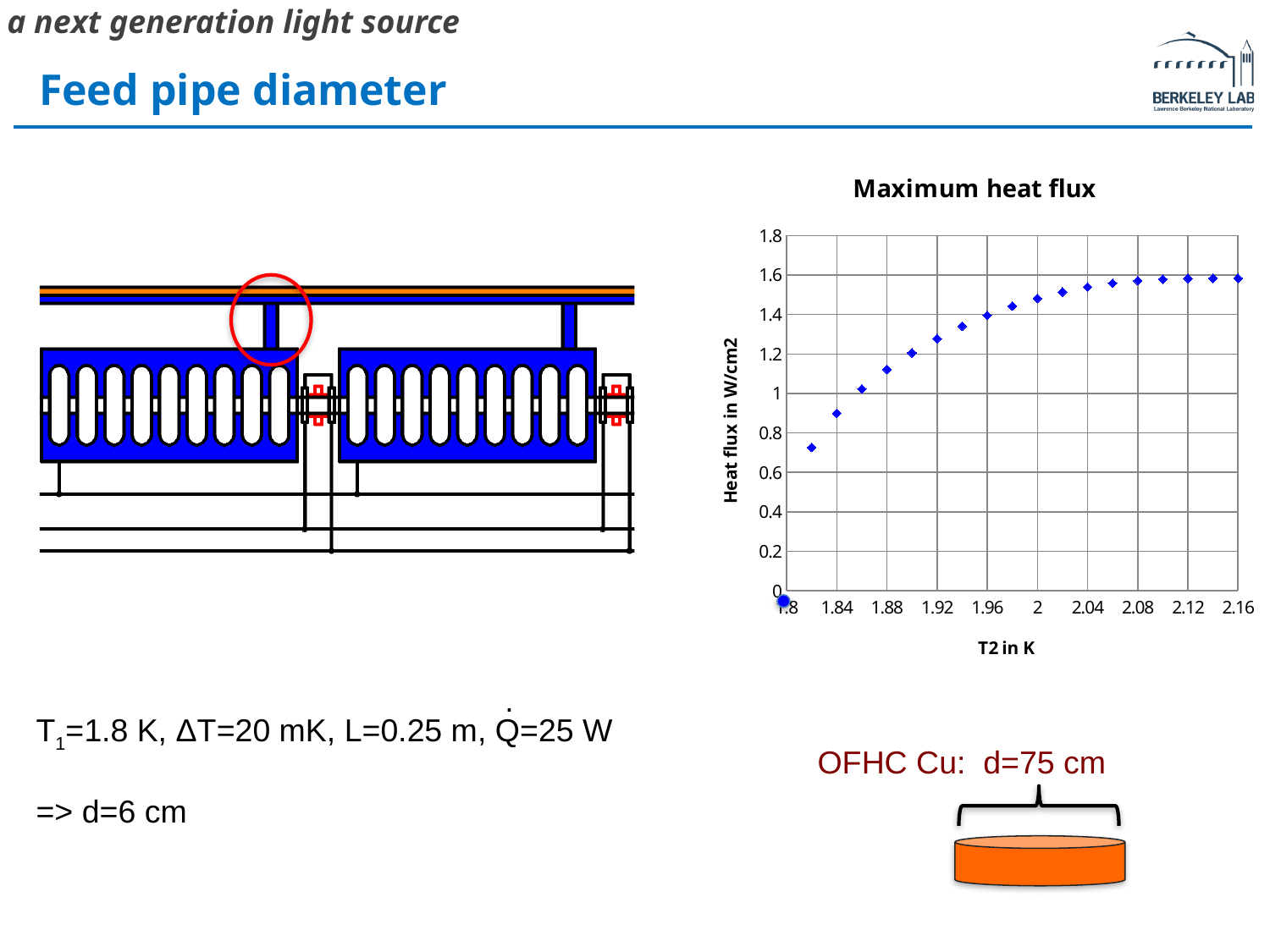
Is the heat flux value at T2 = 1.88 K greater or less than 1? greater Is the heat flux value at T2 = 2 K greater or less than 1.4? greater Is the heat flux value at T2 = 1.92 K greater or less than 1.2? greater Do the heat flux values rise or fall as T2 increases along the x axis? rise Which has the larger heat flux value, T2 = 1.84 K or T2 = 2 K? T2 = 2 K What is the title of the chart? Maximum heat flux What kind of chart is shown on the slide? scatter chart Which has the larger heat flux value, T2 = 1.82 K or T2 = 1.96 K? T2 = 1.96 K What is the label of the x axis of the chart? T2 in K